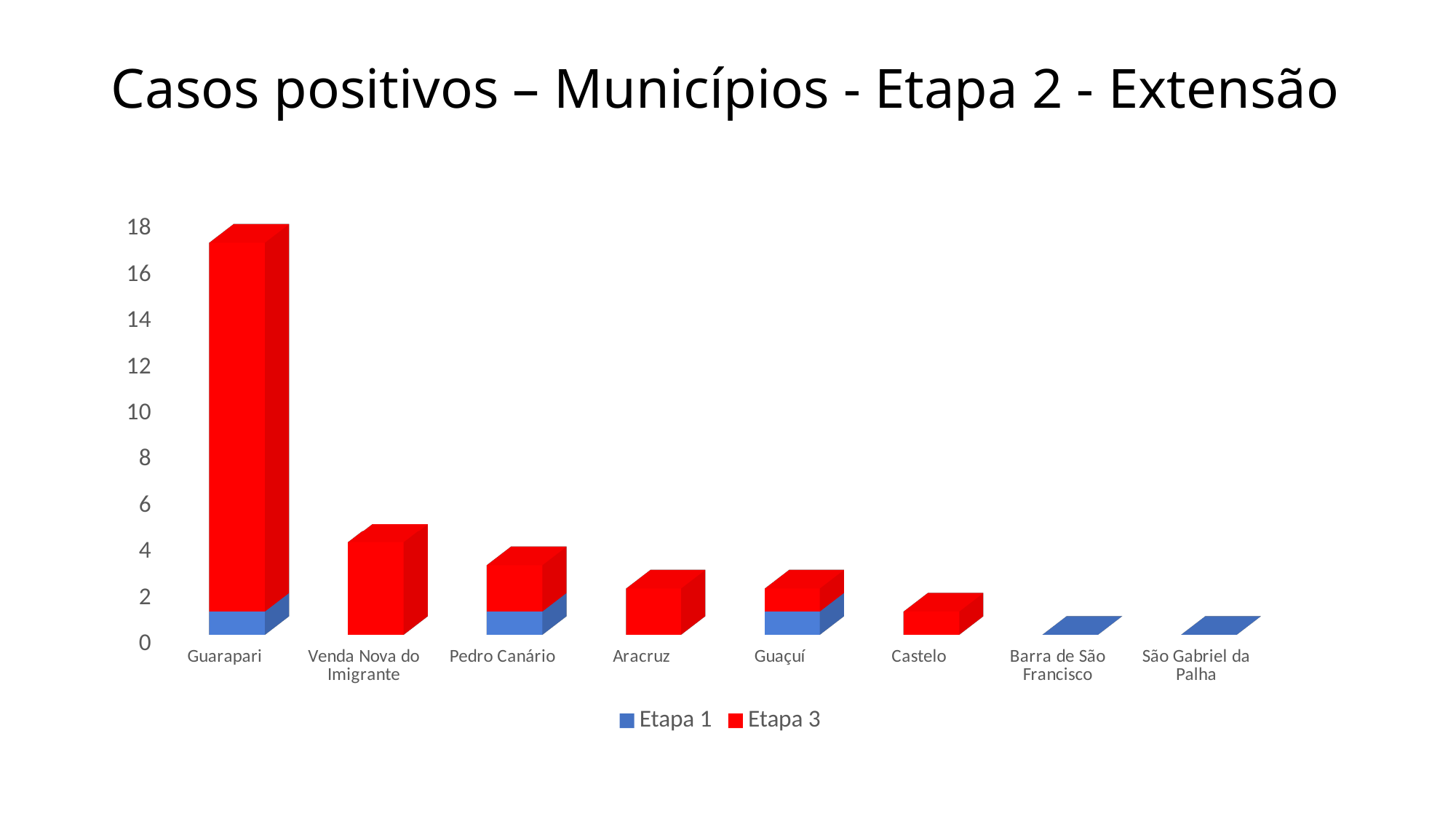
What kind of chart is shown on the slide? bar chart Is the value for Castelo greater or less than 2? less Is the total value for Pedro Canário greater or less than 2? greater Which has the taller bar, Guarapari or Venda Nova do Imigrante? Guarapari Which colour represents the Etapa 3 series in the legend? red How many series does the chart legend list? 2 Is the total value for Guarapari greater or less than 10? greater What is the title of the slide? Casos positivos – Municípios - Etapa 2 - Extensão Which municipality has the tallest bar in the chart? Guarapari How many municipalities are shown on the x axis of the chart? 8 Which has the taller bar, Aracruz or Castelo? Aracruz